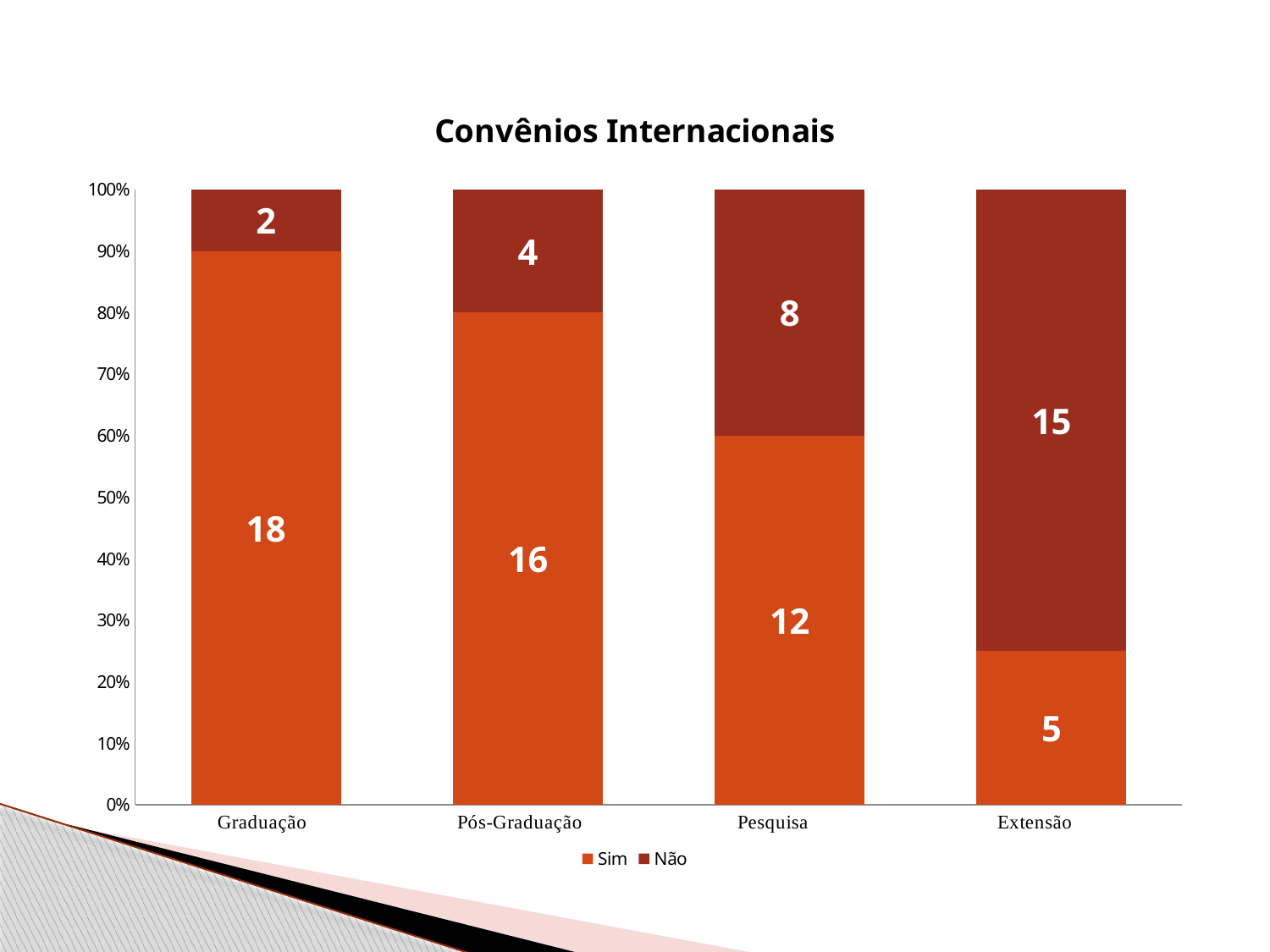
Which category has the lowest Não value? Graduação Which category has the highest Sim value? Graduação How many series does the legend list? 2 What is the value of Não for Extensão? 15 Which is larger for Extensão, the Sim value or the Não value? Não What is the difference between the Sim and Não values for Pós-Graduação? 12 Is the Sim share of the Graduação bar greater or less than 80%? greater What is the value of Não for Pesquisa? 8 How many categories are shown on the x axis? 4 What is the total of the Sim and Não values for Pesquisa? 20 What is the value of Sim for Graduação? 18 What is the title of the chart? Convênios Internacionais